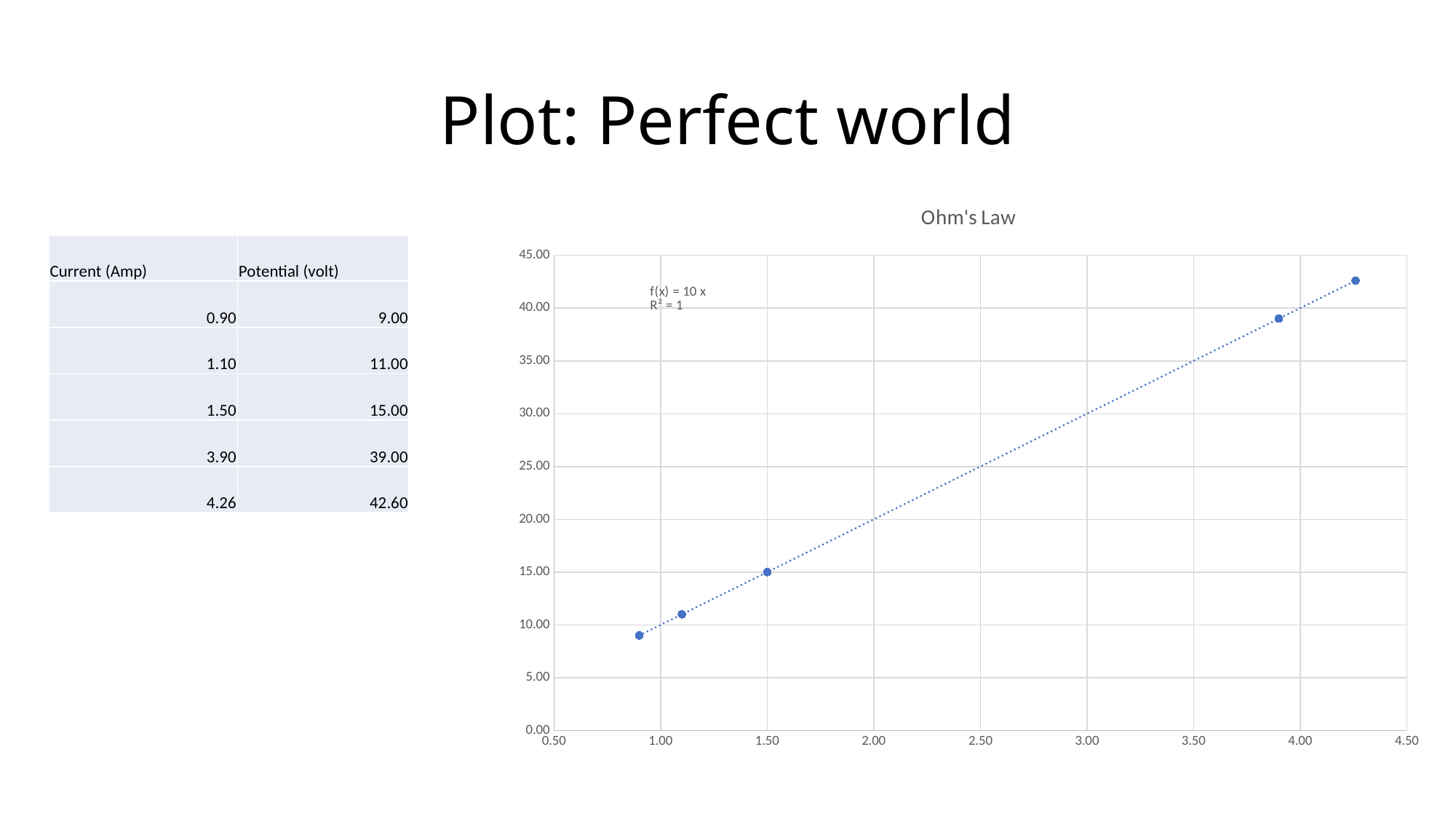
What trendline equation is displayed on the chart? f(x) = 10 x At which current (Amp) is the potential lowest? 0.90 What is the title of the chart? Ohm's Law What is the difference in potential between the points at 3.90 Amp and 1.50 Amp? 24.00 At which current (Amp) is the potential highest? 4.26 What kind of chart is shown on the slide? scatter chart Is the potential at a current of 3.90 Amp greater or less than 35.00? greater What is the potential (volt) at a current of 4.26 Amp? 42.60 Which has the larger potential: the point at 1.10 Amp or the point at 0.90 Amp? 1.10 Amp What is the potential (volt) at a current of 1.50 Amp? 15.00 How many data points are plotted on the chart? 5 Do the plotted values rise or fall as current increases along the x axis? rise